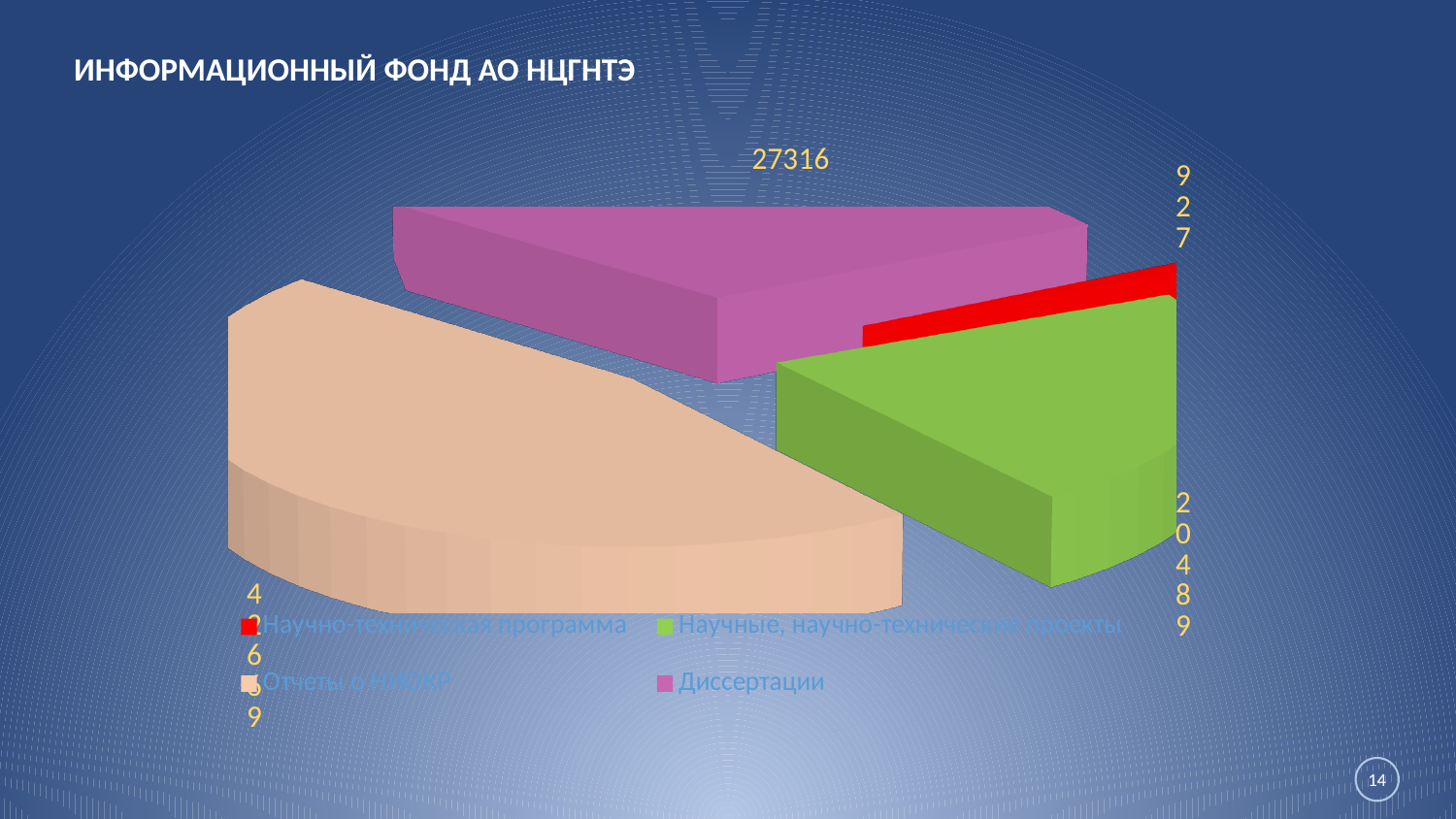
Which is larger, Диссертации or Научные, научно-технические проекты? Диссертации What is the value for Научно-техническая программа? 927 What is the value for Научные, научно-технические проекты? 20489 Which category has the largest slice of the pie? Отчеты о НИОКР What is the value for Диссертации? 27316 What is the difference between the values for Диссертации and Научные, научно-технические проекты? 6827 Which category has the smallest slice of the pie? Научно-техническая программа What kind of chart is shown on the slide? pie chart What is the title of the slide? ИНФОРМАЦИОННЫЙ ФОНД АО НЦГНТЭ What colour is the slice for Диссертации? pink What is the difference between the values for Научные, научно-технические проекты and Научно-техническая программа? 19562 How many categories does the legend of the pie chart list? 4